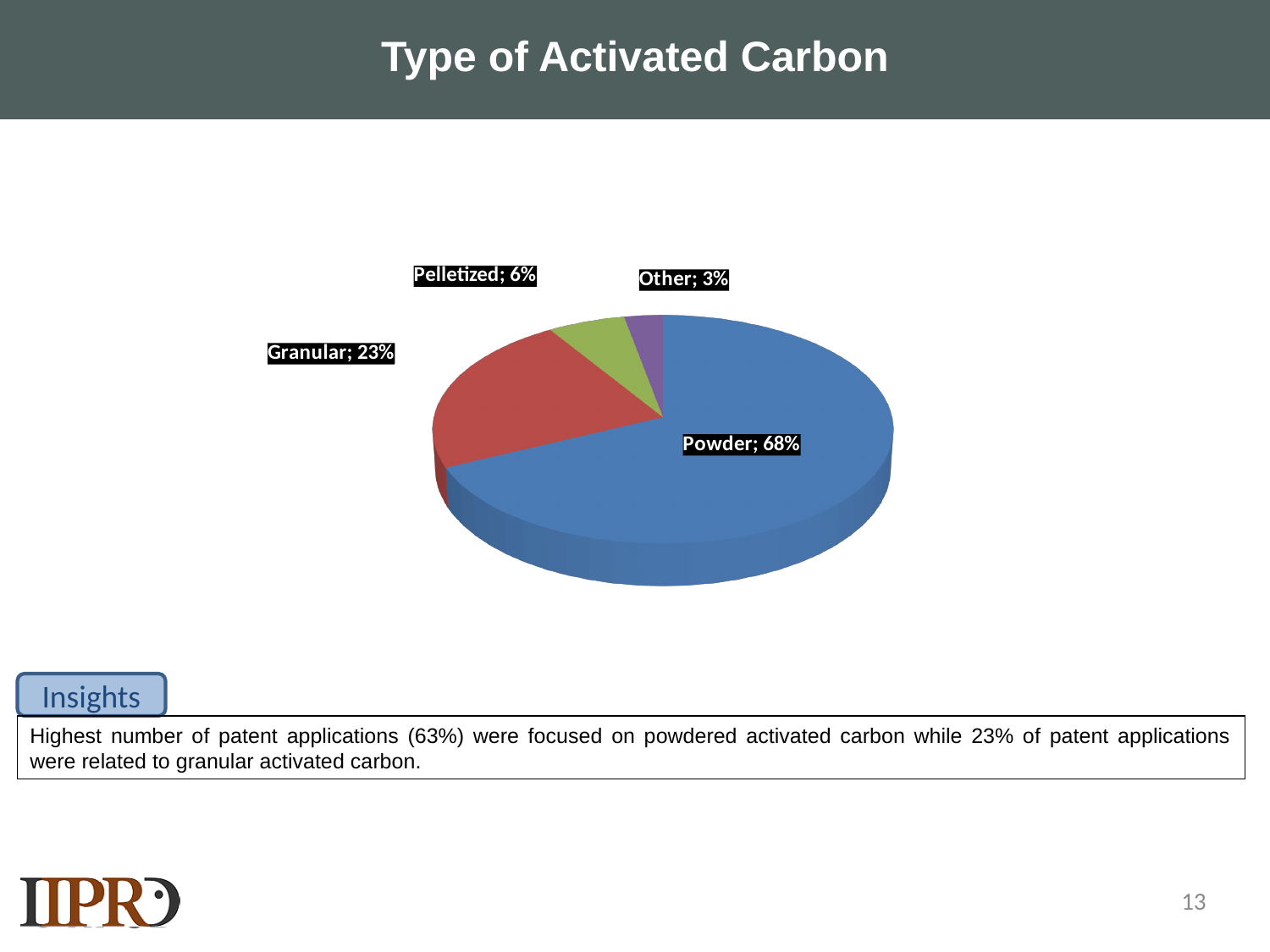
Which is larger, the Granular slice or the Pelletized slice? Granular What is the difference in percentage points between Pelletized and Other? 3 What share of the pie does Other represent? 3% What share of the pie does Granular represent? 23% Which type of activated carbon has the largest slice? Powder What is the title of the chart? Type of Activated Carbon What share of the pie does Pelletized represent? 6% What is the difference in percentage points between Powder and Granular? 45 Which type of activated carbon has the smallest slice? Other What share of the pie does Powder represent? 68% What kind of chart is shown on the slide? Pie chart How many slices does the pie chart have? 4